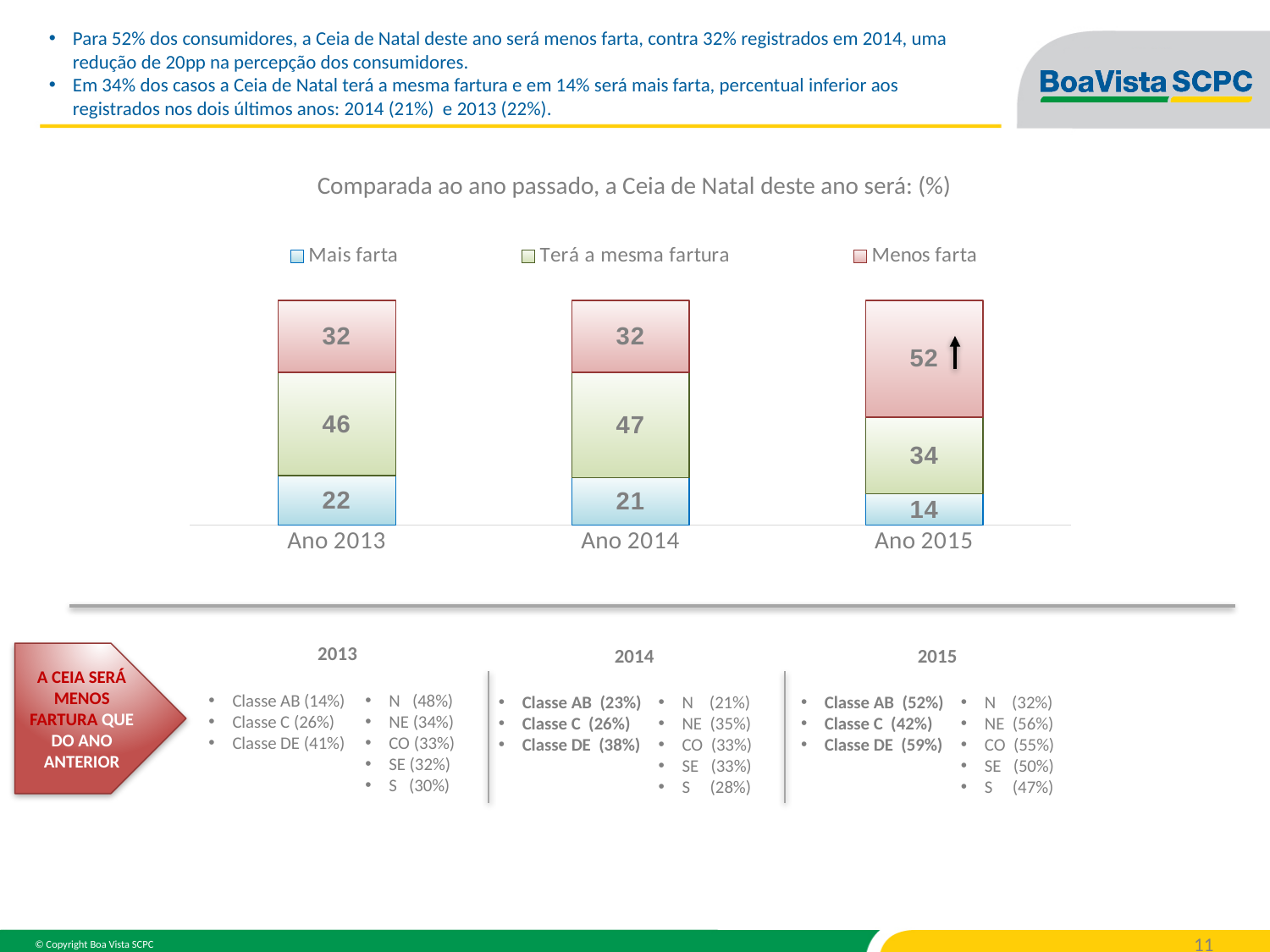
How many series does the legend list? 3 Which year has the lowest value for "Mais farta"? Ano 2015 What is the total of the stacked bar for Ano 2015? 100 What kind of chart is shown? Stacked bar chart How many years are shown on the x axis? 3 What is the value for "Terá a mesma fartura" in Ano 2014? 47 What is the title of the chart? Comparada ao ano passado, a Ceia de Natal deste ano será: (%) Which year has the highest value for "Menos farta"? Ano 2015 Is the "Terá a mesma fartura" value larger in Ano 2013 or Ano 2015? Ano 2013 What is the difference between the "Menos farta" values for Ano 2015 and Ano 2014? 20 What is the value for "Menos farta" in Ano 2015? 52 What is the value for "Mais farta" in Ano 2013? 22